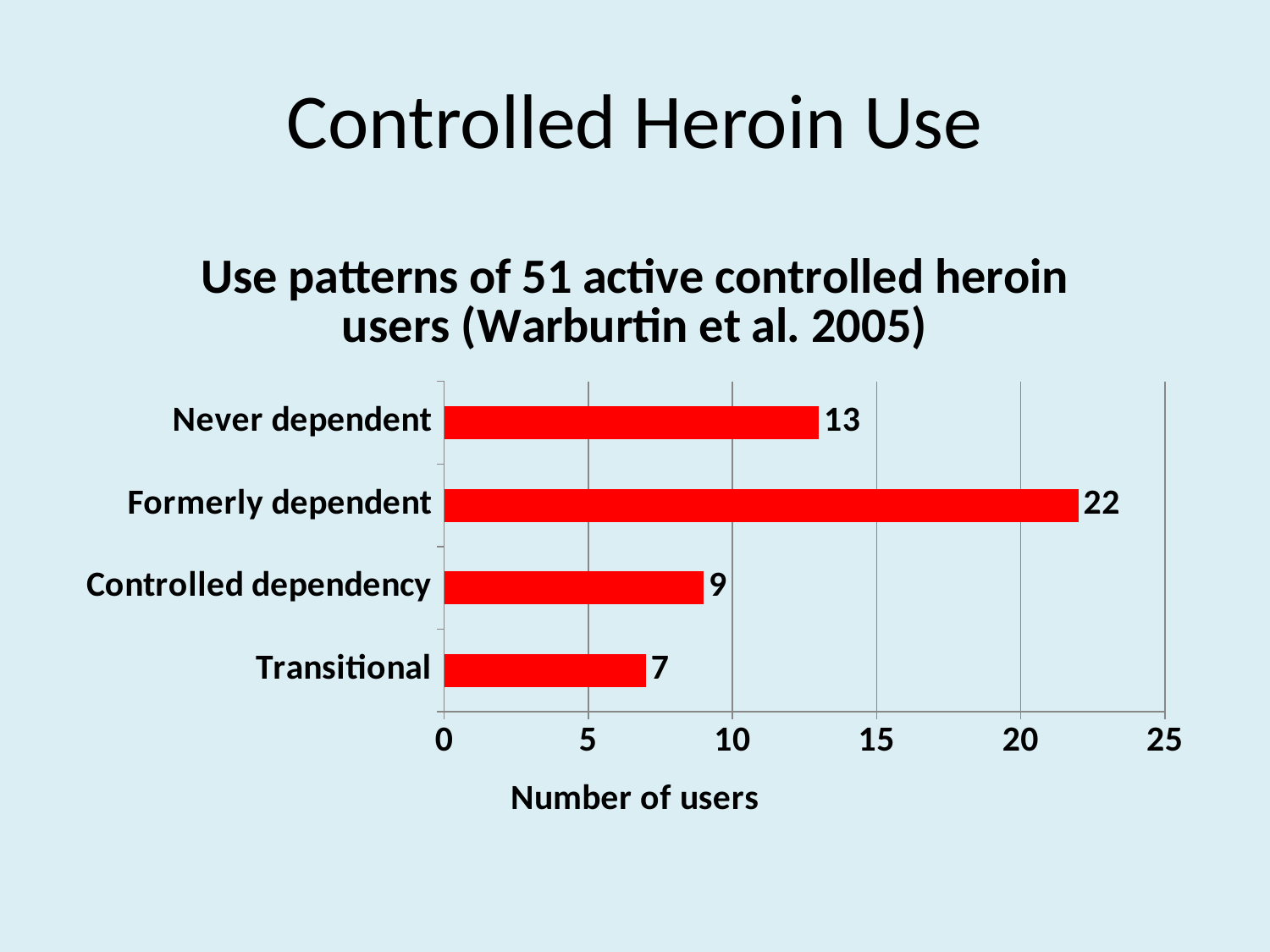
What is the number of users for Formerly dependent? 22 Which category has the highest number of users? Formerly dependent What is the number of users for Controlled dependency? 9 Is the value for Never dependent greater or less than 10? greater What is the number of users for Transitional? 7 What kind of chart is shown on the slide? Bar chart What is the difference in number of users between Formerly dependent and Never dependent? 9 What is the label of the horizontal axis? Number of users How many categories are shown in the chart? 4 Which has more users, Controlled dependency or Transitional? Controlled dependency Which category has the lowest number of users? Transitional What is the number of users for Never dependent? 13